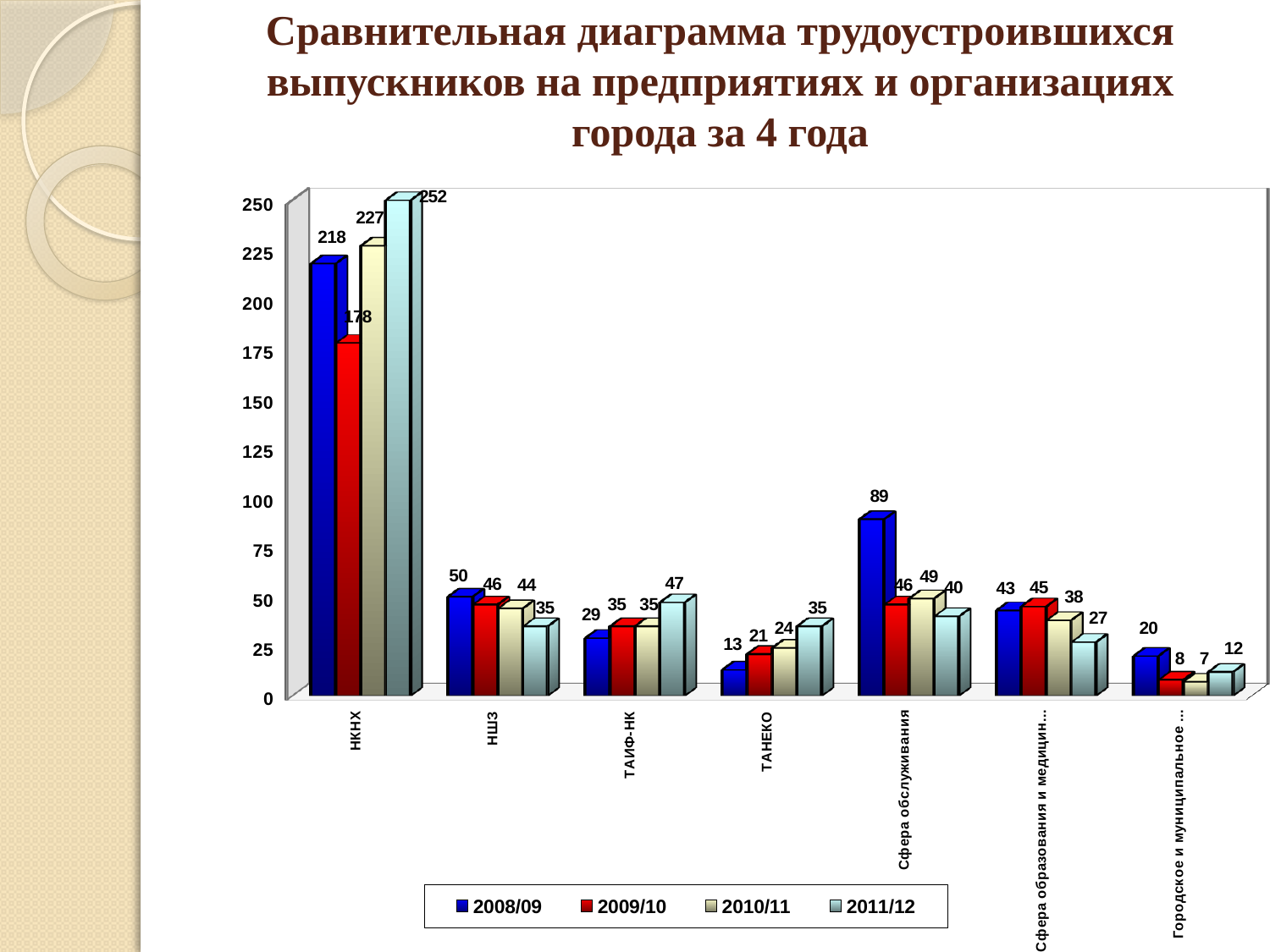
Do the values for ТАНЕКО rise or fall from 2008/09 to 2011/12? rise What kind of chart is shown on the slide? bar chart Which is larger for НШЗ: the 2008/09 value or the 2011/12 value? 2008/09 Which category has the highest value in the 2010/11 series? НКНХ What is the value for Сфера обслуживания in the 2008/09 series? 89 Which category has the lowest value in the 2009/10 series? Городское и муниципальное ... What is the value for ТАНЕКО in the 2008/09 series? 13 How many series does the legend list? 4 How many categories are shown on the x axis? 7 What is the difference between the 2011/12 and 2008/09 values for НКНХ? 34 Is the 2009/10 value for НКНХ greater or less than 200? less What is the value for НКНХ in the 2011/12 series? 252